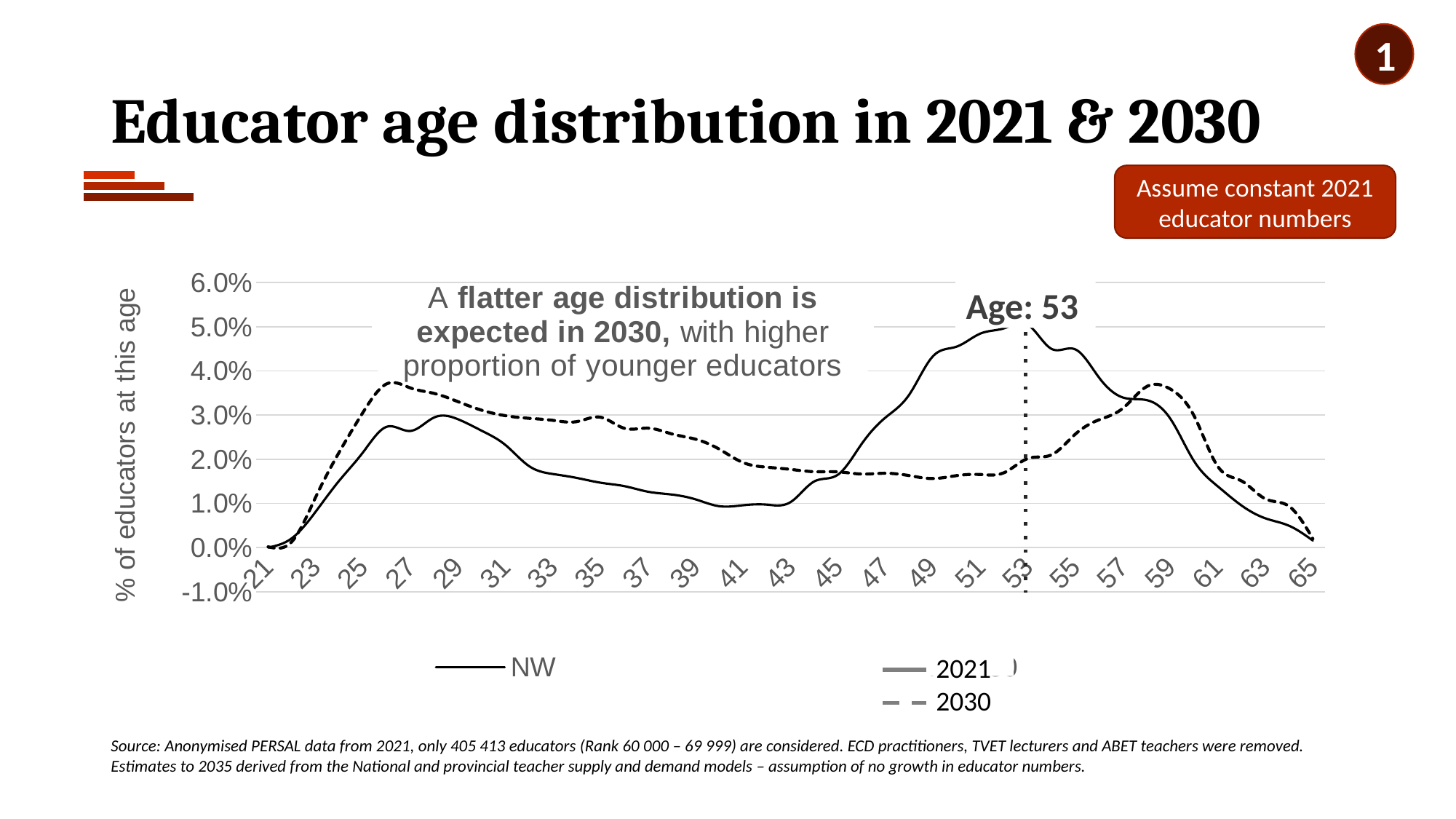
Is the value of the 2021 line at age 53 greater or less than 4.0%? greater At which age does the 2021 (solid) line reach its highest value? 53 Is the value of the 2030 line at age 27 greater or less than 3.0%? greater What kind of chart is shown on the slide? line chart How many series does the 2021/2030 legend list? 2 Is the value of the 2030 line at age 53 greater or less than 3.0%? less Does the 2021 line rise or fall between age 29 and age 41? fall Which year does the dashed line represent? 2030 At age 27, which line is higher, 2021 or 2030? 2030 At age 53, which line is higher, 2021 or 2030? 2021 What is the label on the vertical axis? % of educators at this age